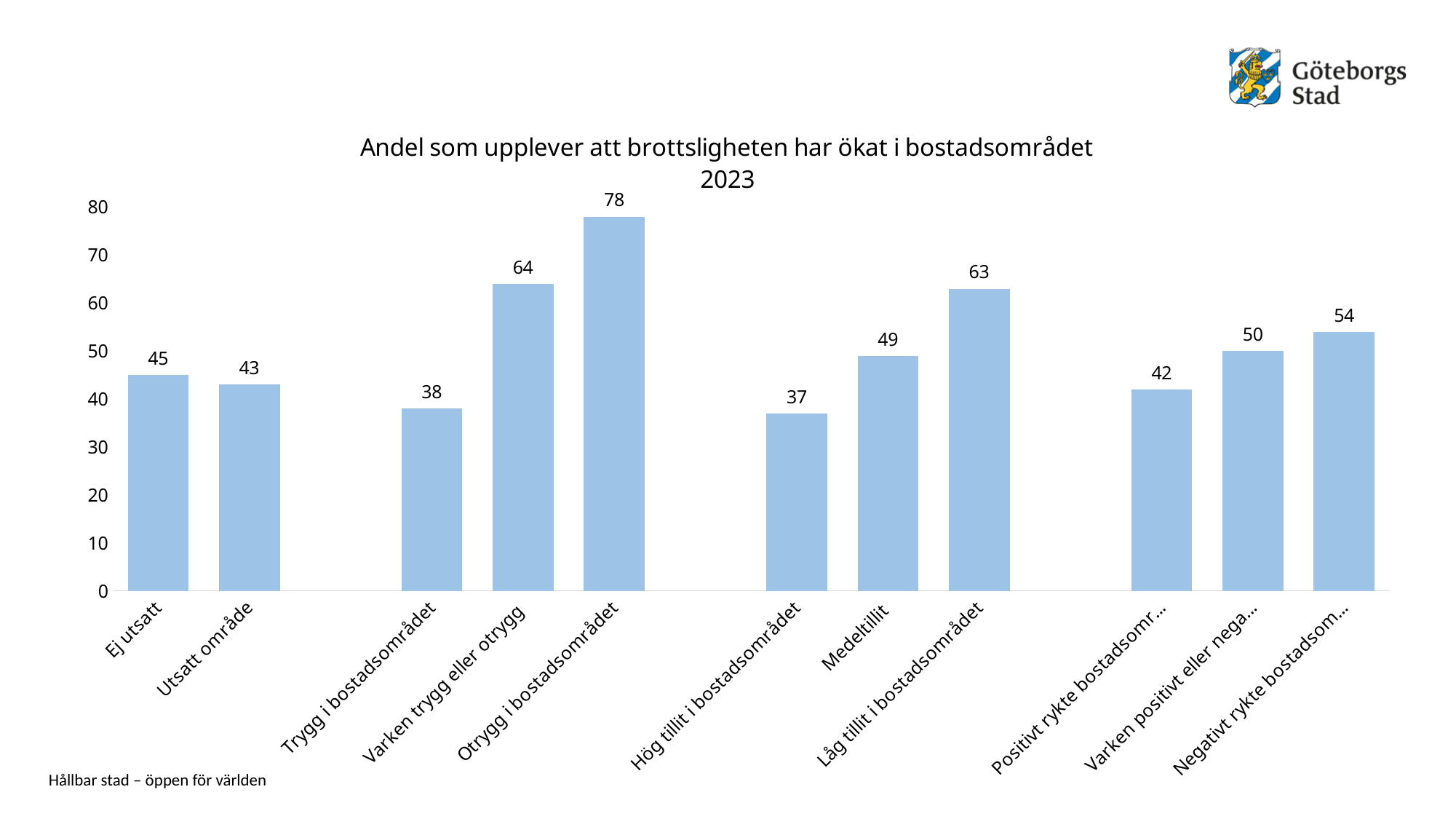
Which category has the highest value? Otrygg i bostadsområdet What is the difference between the values for Otrygg i bostadsområdet and Trygg i bostadsområdet? 40 What is the value for Hög tillit i bostadsområdet? 37 How many bars are shown in the chart? 11 What year is shown in the chart title? 2023 What is the value for Medeltillit? 49 Is the value for Utsatt område greater or less than 50? less What kind of chart is shown on the slide? bar chart Which category has the lowest value? Hög tillit i bostadsområdet What is the value for Otrygg i bostadsområdet? 78 What is the value for Ej utsatt? 45 Which is larger, the value for Varken trygg eller otrygg or the value for Låg tillit i bostadsområdet? Varken trygg eller otrygg